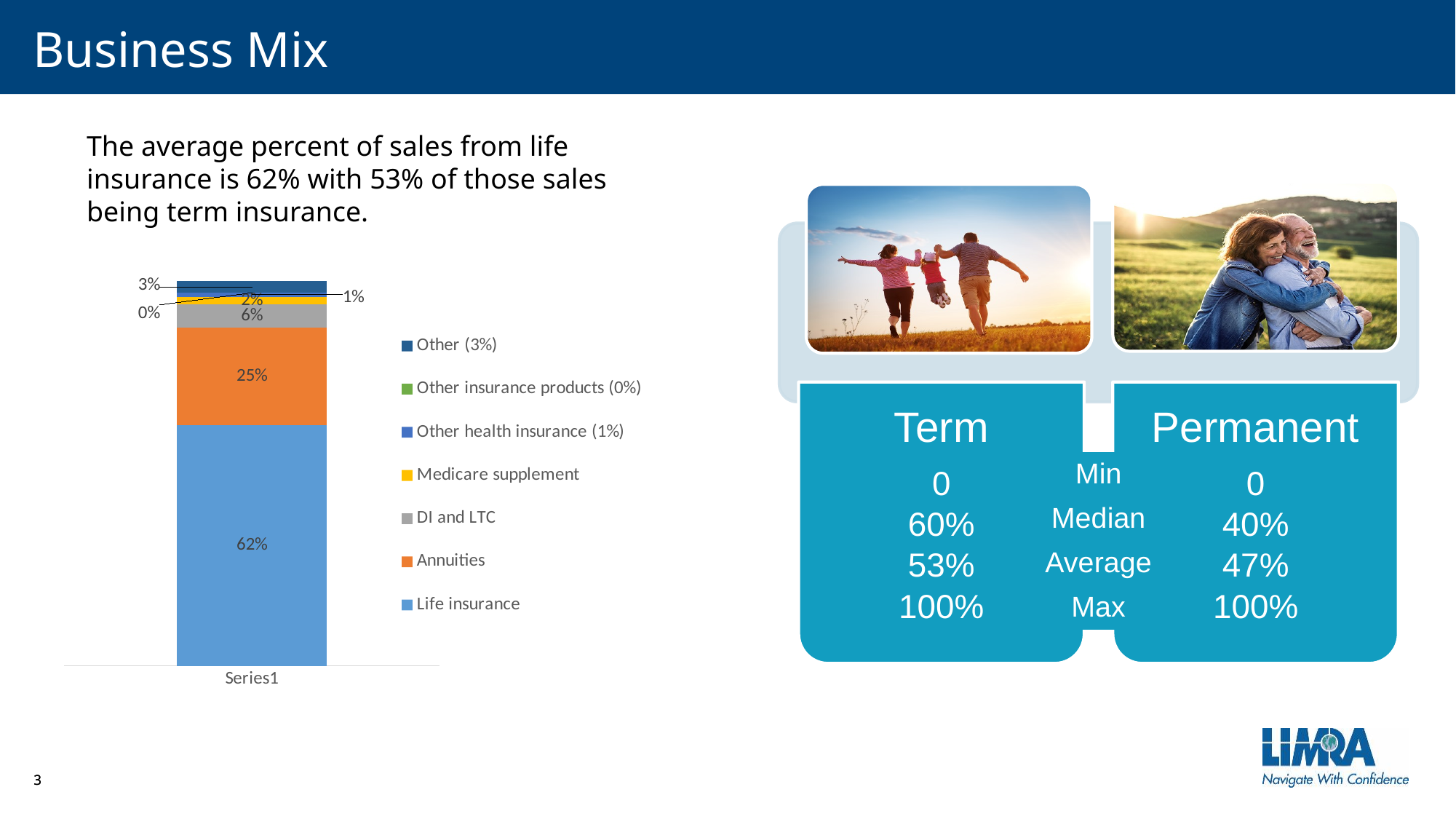
What kind of chart is shown on the left of the slide? Stacked bar chart How many entries does the legend of the bar chart list? 7 Which segment of the stacked bar has the largest value? Life insurance What value is labelled for DI and LTC in the bar chart? 6% What is the difference between the Life insurance and Annuities percentages in the bar chart? 37% Which segment of the stacked bar has the smallest value? Other insurance products What percentage does the Annuities segment show in the bar chart? 25% What is the difference between the Annuities and DI and LTC percentages in the bar chart? 19% What percentage is shown for Medicare supplement in the bar chart? 2% What percentage of the stacked bar is Life insurance? 62% In the bar chart, which is larger: DI and LTC or Other? DI and LTC What percentage is shown for the Other segment in the bar chart? 3%